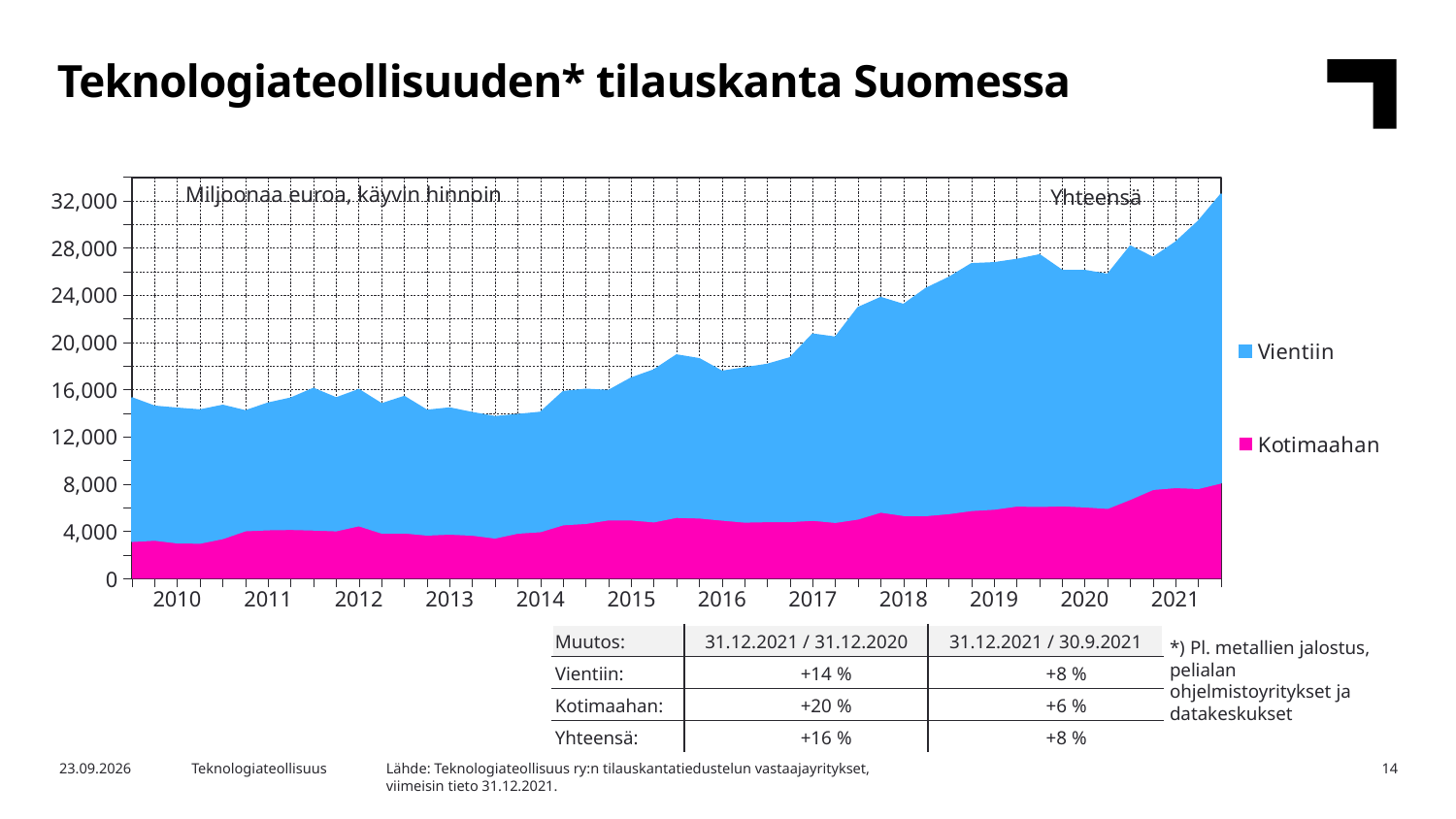
Does the total order backlog (Yhteensä) rise or fall overall from 2010 to 2021? rise What kind of chart is shown on the slide? Stacked area chart Is the Kotimaahan value at the end of 2021 greater or less than 4,000? greater Is the Kotimaahan value at the start of 2010 greater or less than 4,000? less Is the total (Yhteensä) value at the end of 2021 greater or less than 28,000? greater What unit is stated in the chart's label at the top left of the plot area? Miljoonaa euroa, käyvin hinnoin How many series does the chart legend list? 2 What are the two series named in the chart legend? Vientiin and Kotimaahan Which series is larger at the end of 2021, Vientiin or Kotimaahan? Vientiin How many years are labelled on the x axis of the chart? 12